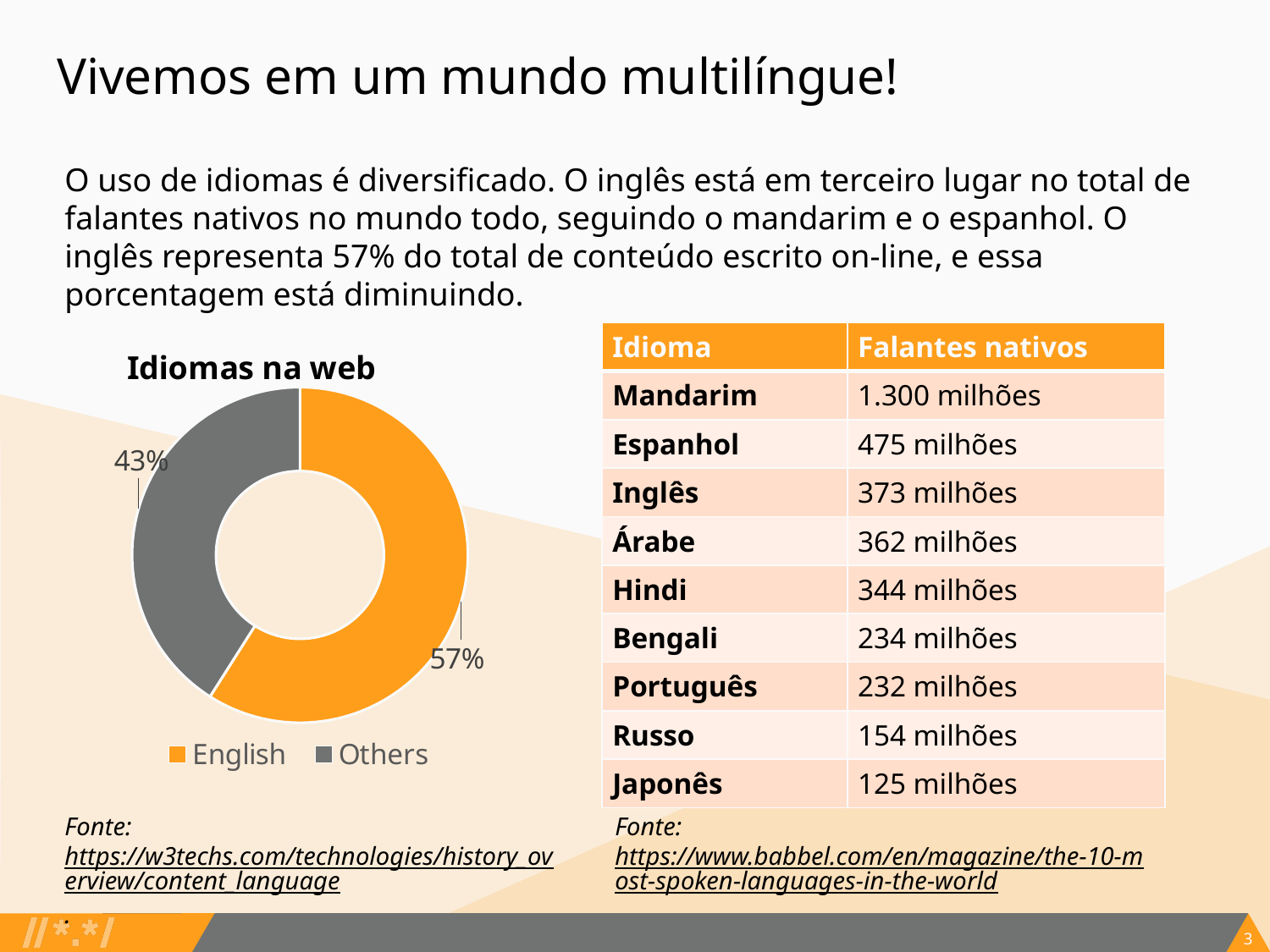
Which category has the largest share in the chart? English Which category has the smallest share in the chart? Others Which is larger, the share for English or the share for Others? English Is the share for English greater or less than 50%? greater How many entries does the chart legend list? 2 How many categories does the chart show? 2 What share of the chart does Others represent? 43% Which colour represents English in the chart? orange What is the title of the chart on the slide? Idiomas na web What is the difference in percentage points between English and Others? 14 What share of the chart does English represent? 57% What kind of chart is shown on the slide? doughnut chart